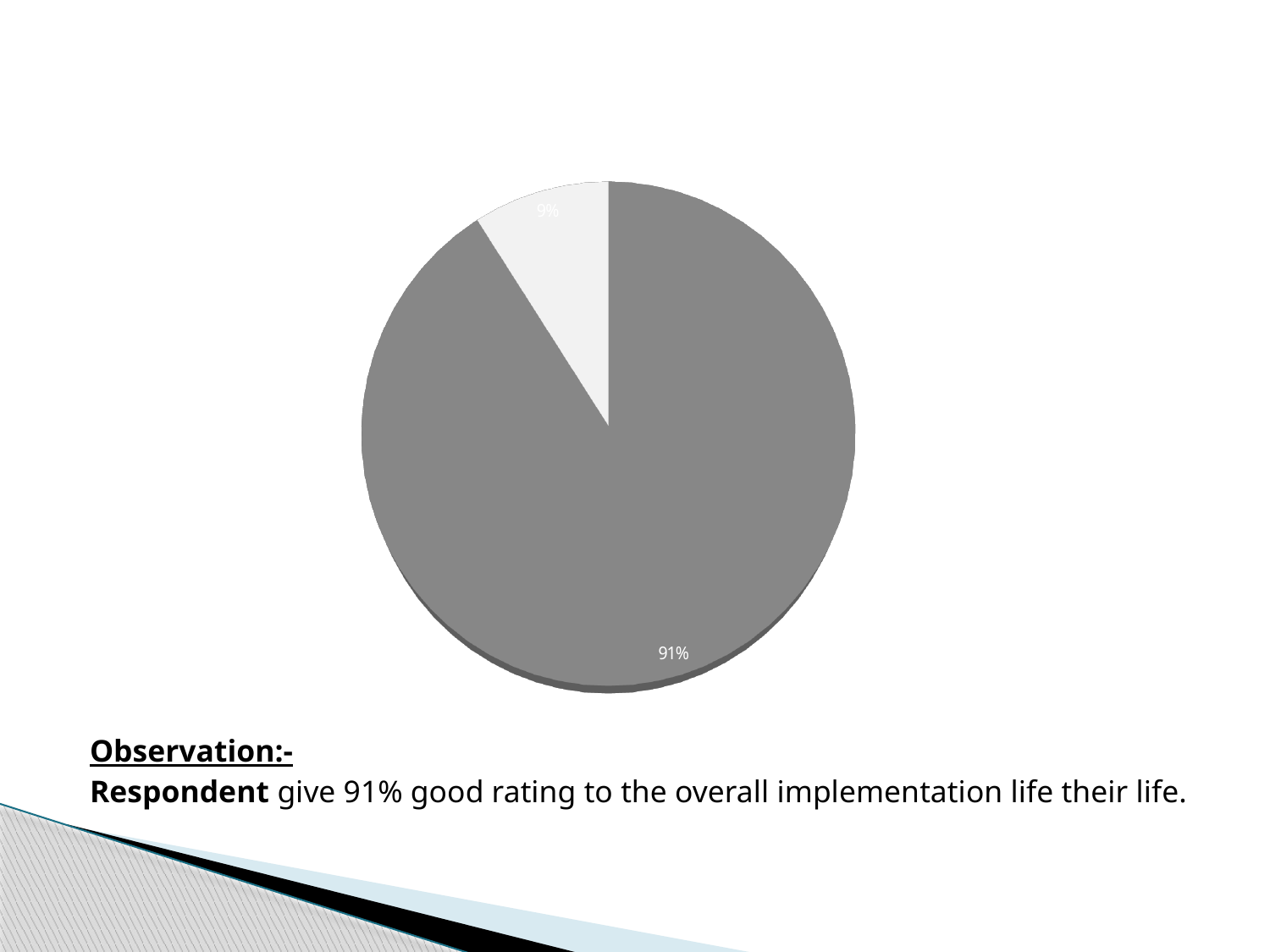
What kind of chart is shown on the slide? pie chart What percentage is shown on the smallest slice of the pie chart? 9% How many slices does the pie chart have? 2 Which slice is larger in the pie chart, the dark grey slice or the light grey slice? the dark grey slice What is the difference in percentage points between the two slices of the pie chart? 82 Does the pie chart have a legend? No What share of the pie does the light grey slice represent? 9% What value is labelled on the dark grey slice of the pie chart? 91% What value is labelled on the light grey slice of the pie chart? 9% What percentage is shown on the largest slice of the pie chart? 91% Is the value of the dark grey slice greater or less than 50%? greater According to the observation text below the chart, what percentage of respondents gave a good rating? 91%